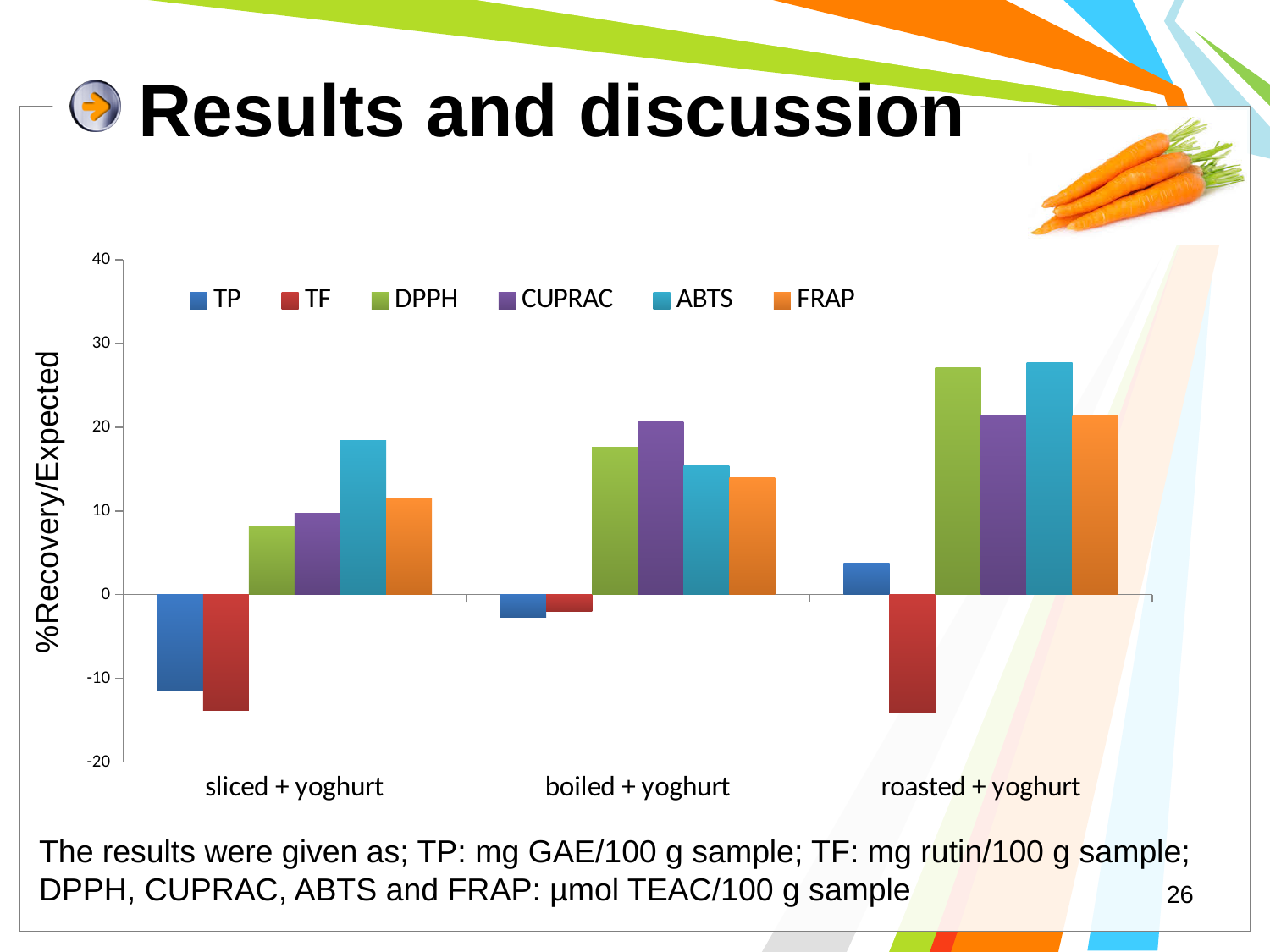
Is the value for TP in the roasted + yoghurt category greater or less than 0? greater Is the value for TF in the roasted + yoghurt category greater or less than -10? less Is the value for ABTS in the sliced + yoghurt category greater or less than 10? greater How many categories are shown on the x axis? 3 How many series does the legend list? 6 In the boiled + yoghurt category, which is larger, CUPRAC or ABTS? CUPRAC Which series has the lowest value in the sliced + yoghurt category? TF Which is larger, the DPPH value for boiled + yoghurt or for sliced + yoghurt? boiled + yoghurt What kind of chart is shown on the slide? bar chart Which category has the highest DPPH value? roasted + yoghurt What is the label on the y axis? %Recovery/Expected Do the DPPH values rise or fall from sliced + yoghurt to roasted + yoghurt? rise